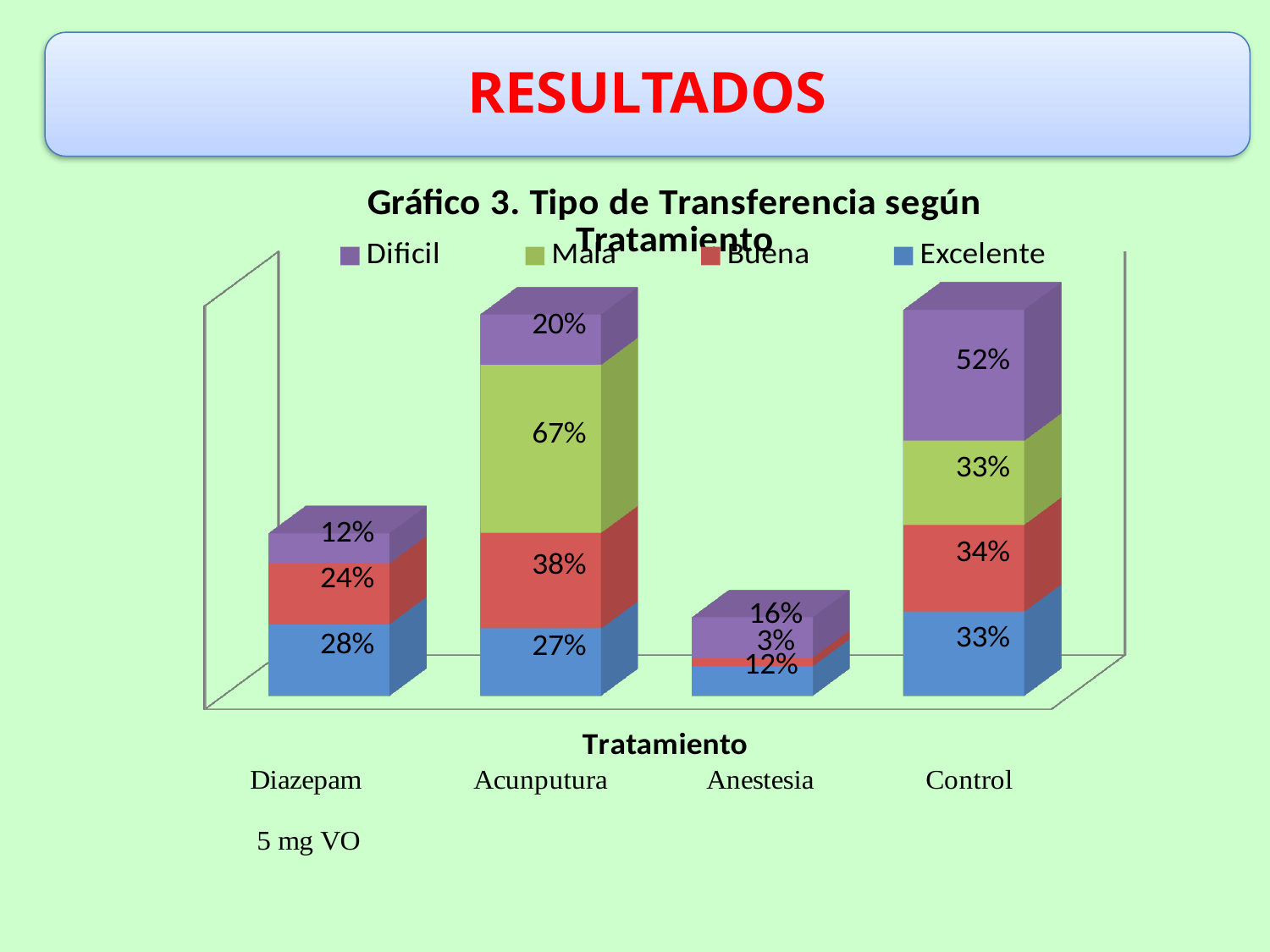
What kind of chart is shown on the slide? Stacked bar chart Which treatment has the highest Dificil value? Control What is the title of the chart? Gráfico 3. Tipo de Transferencia según Tratamiento What is the Mala value for Acunputura? 67% What is the difference between the Dificil value for Control and the Dificil value for Acunputura? 32% How many treatment categories are shown on the x axis? 4 Which has the larger Excelente value, Diazepam or Acunputura? Diazepam What is the Buena value for Diazepam? 24% What is the Excelente value for Control? 33% Which treatment has the lowest Buena value? Anestesia What is the Dificil value for Anestesia? 16% How many series does the legend list? 4